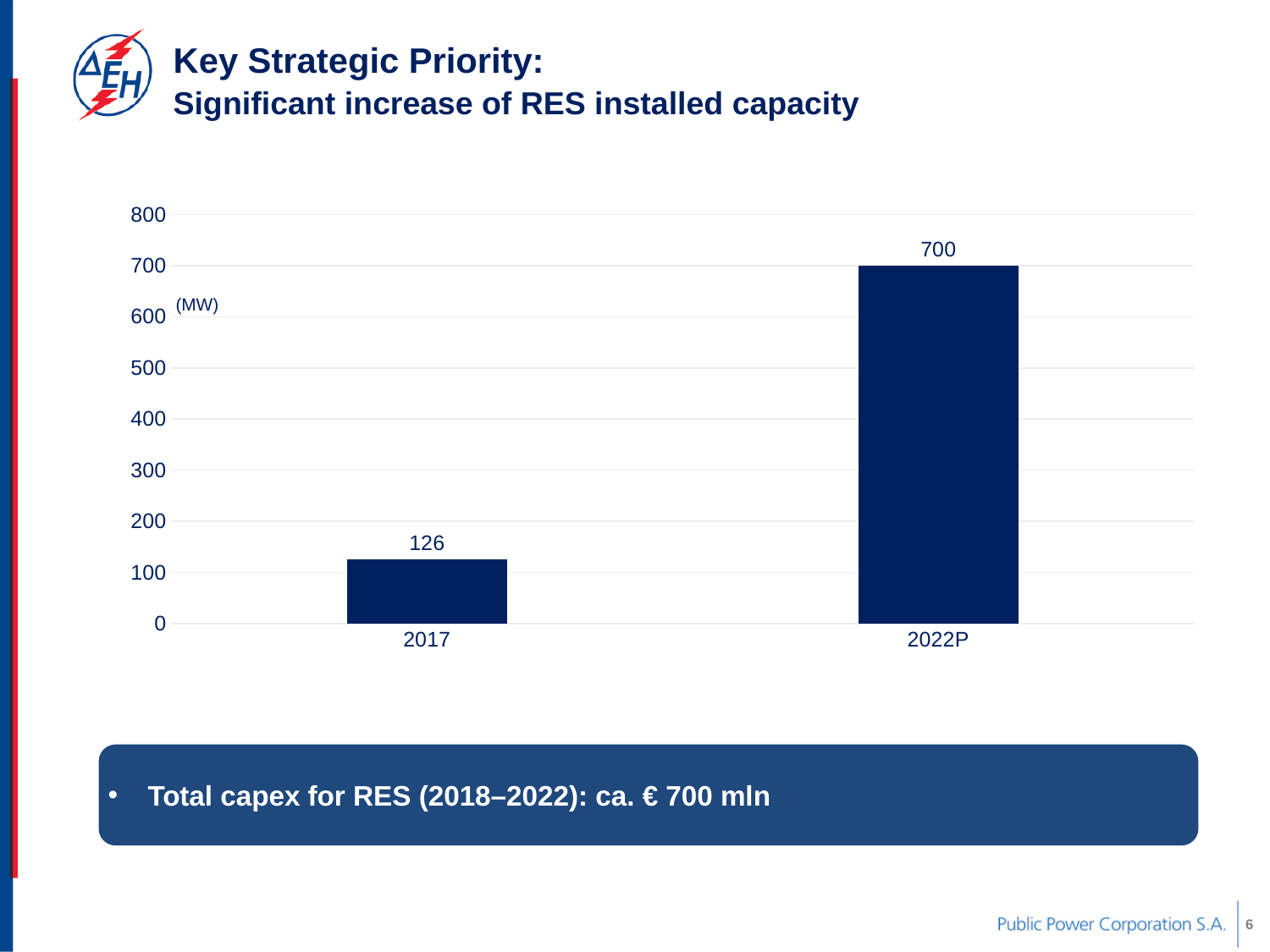
What is the difference between the 2022P value and the 2017 value? 574 Which category has the highest value in the chart? 2022P What kind of chart is shown on the slide? bar chart Which category has the lowest value in the chart? 2017 Do the values rise or fall from 2017 to 2022P? rise Is the value for 2017 greater or less than 200? less What is the RES installed capacity value shown for 2022P? 700 How many categories are shown on the x axis of the chart? 2 What unit is indicated on the chart's y axis? MW Which is larger, the value for 2017 or the value for 2022P? 2022P What is the RES installed capacity value shown for 2017? 126 Is the value for 2022P greater or less than 600? greater